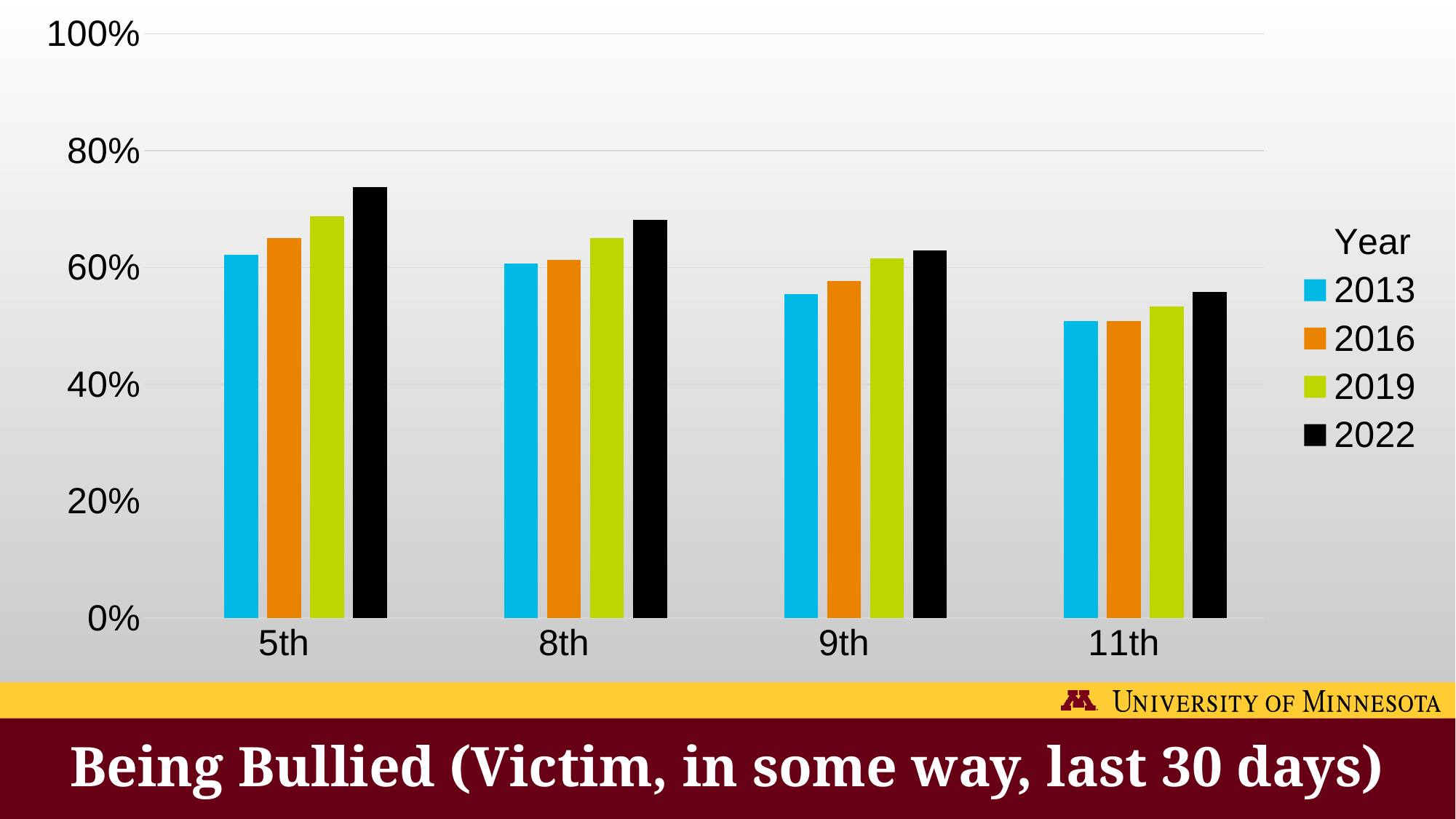
Is the 2013 value for 11th grade greater or less than 40%? greater How many years does the legend list? 4 Is the 2022 value for 5th grade greater or less than 60%? greater Which grade has the highest value for 2022? 5th Is the 2013 value for 9th grade greater or less than 60%? less Do the 2022 values rise or fall from 5th grade to 11th grade? fall What kind of chart is shown on the slide? bar chart How many grade categories are shown on the x axis? 4 What is the title of the legend? Year Which grade has the lowest value for 2022? 11th Which is larger, the 2022 value for 5th grade or the 2022 value for 11th grade? 5th grade